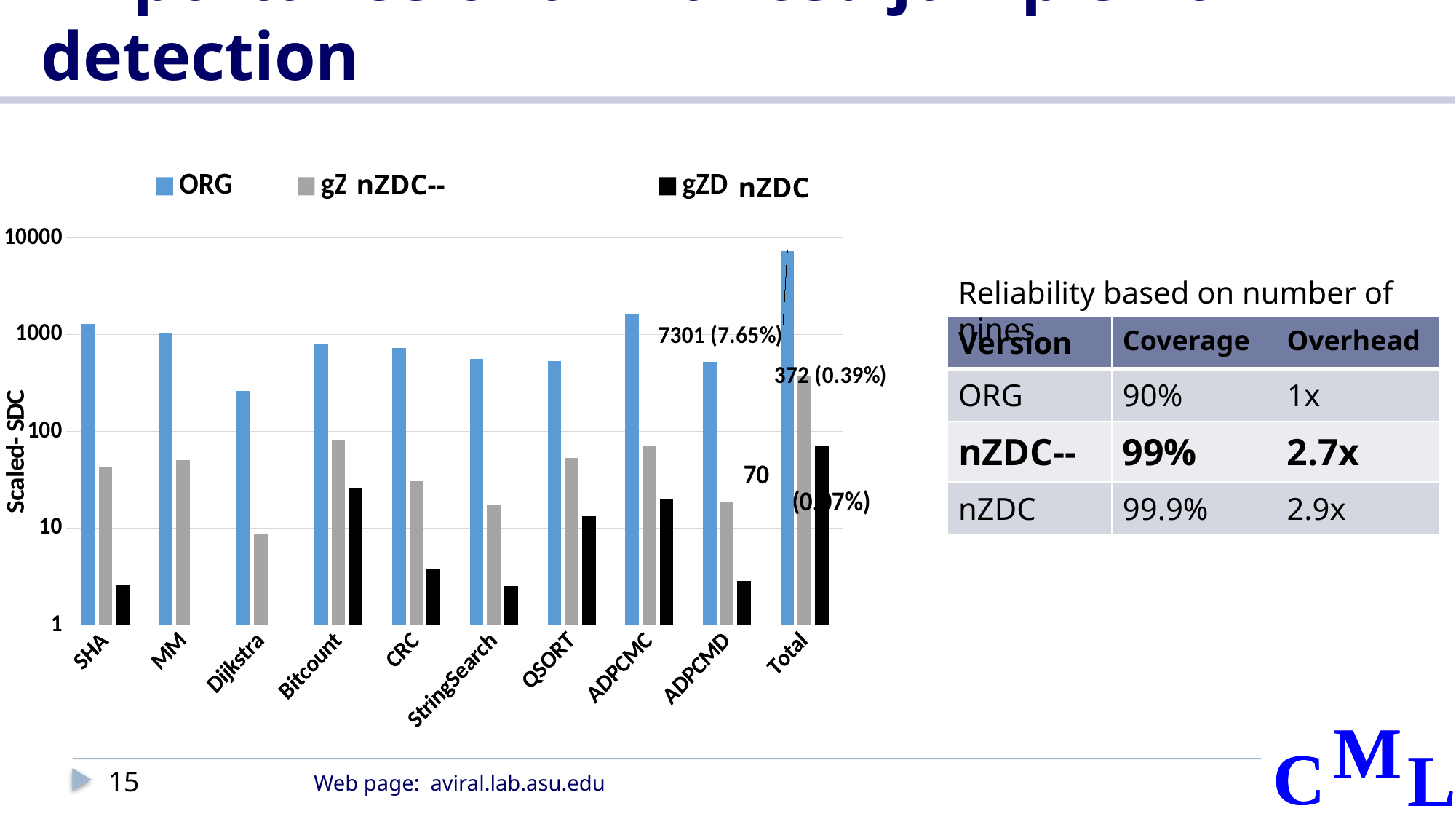
What is the ORG value labelled for the Total category? 7301 Which category has the lowest ORG bar? Dijkstra Is the ORG value for Dijkstra greater or less than 1000? less What is the nZDC value labelled for the Total category? 70 Is the nZDC value for Bitcount greater or less than 10? greater Which is larger, the ORG value for SHA or the ORG value for Dijkstra? SHA What is the nZDC-- value labelled for the Total category? 372 Which category has the highest ORG bar? Total How many series does the chart's legend list? 3 What kind of chart is shown on the slide? bar chart What is the difference between the ORG and nZDC-- values for the Total category? 6929 How many categories are shown along the x axis of the chart? 10